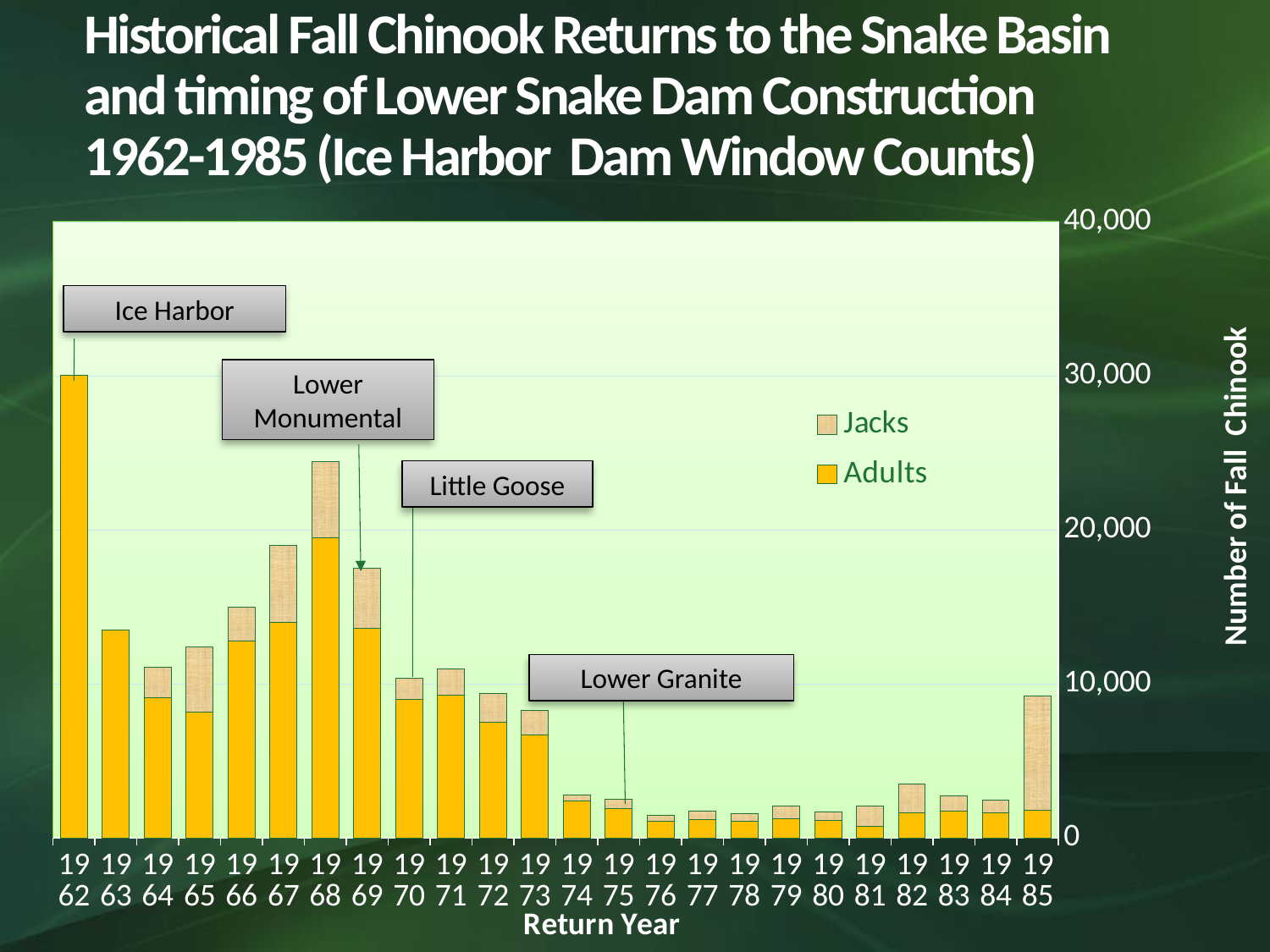
Which return year has the larger total, 1974 or 1985? 1985 What are the two series named in the legend? Jacks and Adults Which return year has the highest total number of fall Chinook? 1962 Is the total value for 1976 greater or less than 10,000? less Is the total value for 1968 greater or less than 20,000? greater Is the total value for 1963 greater or less than 10,000? greater Do the total values rise or fall from 1968 to 1978? fall How many return years are plotted on the x axis? 24 What kind of chart is shown on the slide? Stacked bar chart How many series does the legend list? 2 Which return year has the larger total, 1968 or 1969? 1968